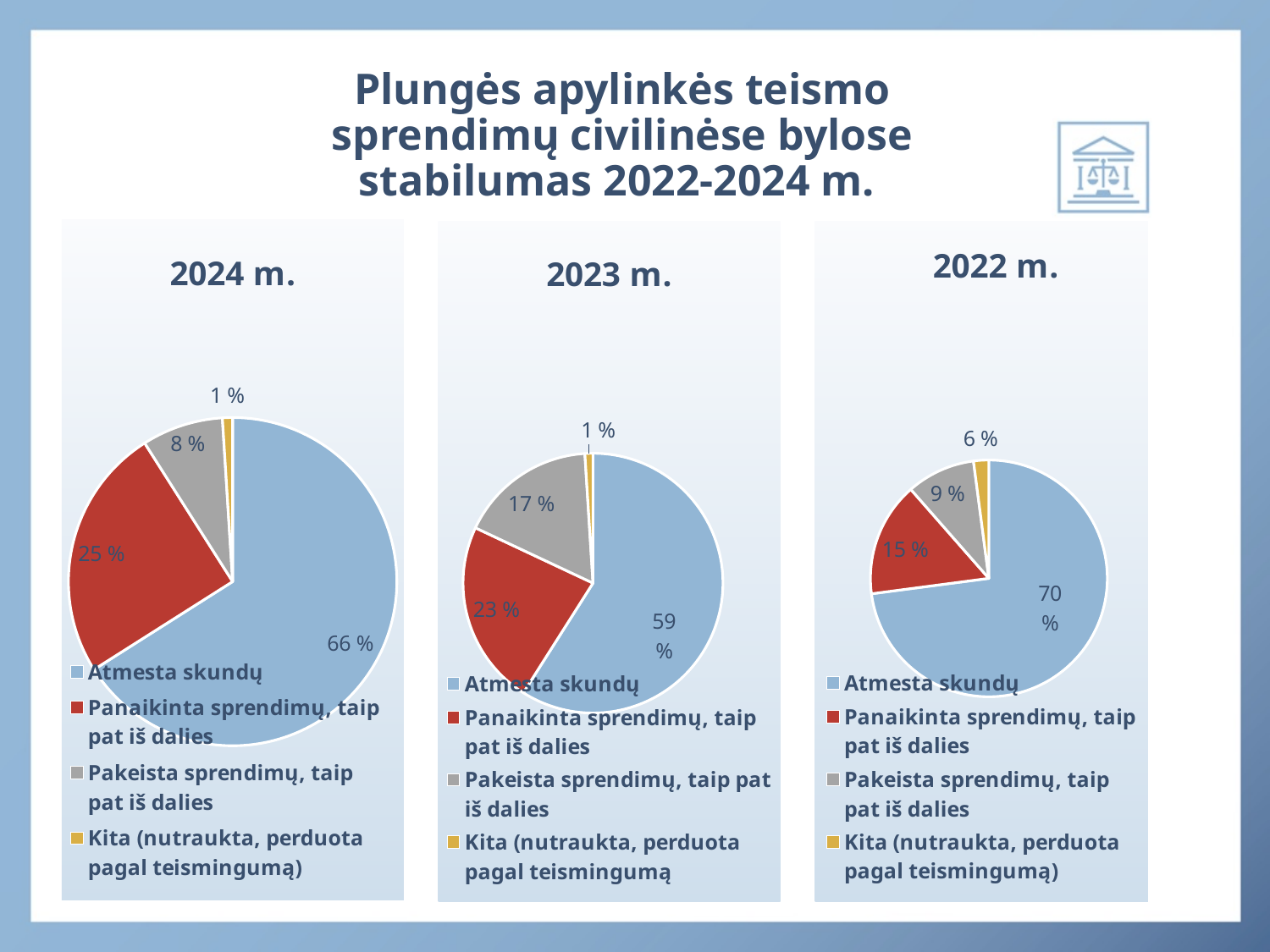
In the 2023 m. chart, what share is labelled for Pakeista sprendimų, taip pat iš dalies? 17 % In the 2023 m. chart, which category has the largest slice? Atmesta skundų Which is larger: the Atmesta skundų share in the 2022 m. chart or in the 2023 m. chart? 2022 m. In the 2024 m. chart, what is the difference between the Panaikinta sprendimų, taip pat iš dalies slice and the Pakeista sprendimų, taip pat iš dalies slice? 17 % In the 2024 m. chart, what colour is the Panaikinta sprendimų, taip pat iš dalies slice? Red In the 2022 m. chart, what share is labelled for Panaikinta sprendimų, taip pat iš dalies? 15 % In the 2024 m. chart, what share is labelled for Atmesta skundų? 66 % How many slices does the 2023 m. pie chart have? 4 In the 2024 m. chart, which category has the smallest slice? Kita (nutraukta, perduota pagal teismingumą) In the 2022 m. chart, what share is labelled for Kita (nutraukta, perduota pagal teismingumą)? 6 % How many pie charts are shown on the slide? 3 What type of chart is used for 2022 m.? Pie chart